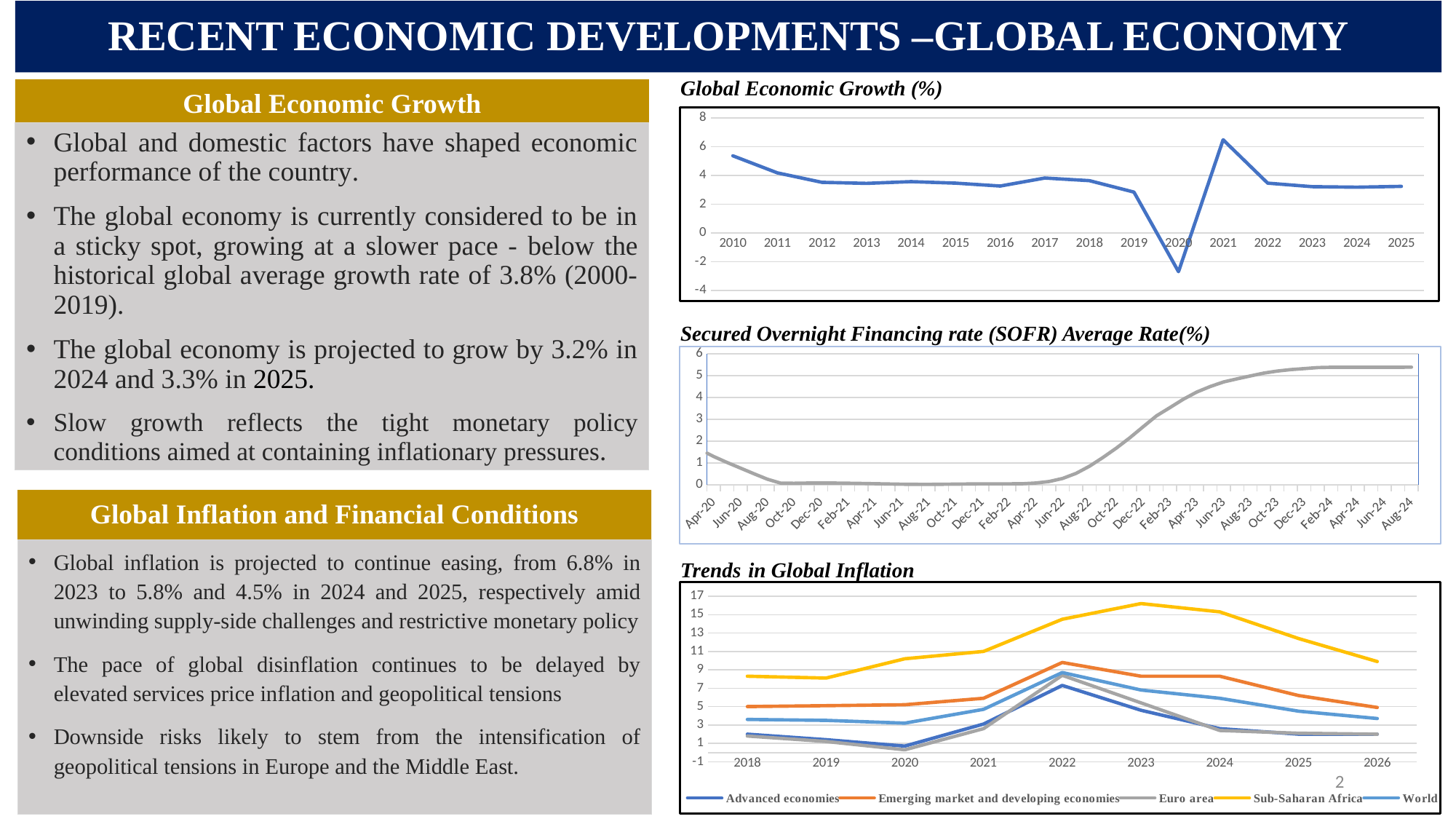
In the 'Trends in Global Inflation' chart, how many series does the legend list? 5 In the 'Global Economic Growth (%)' chart, is the value for 2021 greater or less than 6? greater In the 'Secured Overnight Financing rate (SOFR) Average Rate(%)' chart, is the value for Oct-20 greater or less than 1? less In the 'Global Economic Growth (%)' chart, how many years are shown on the x axis? 16 In the 'Global Economic Growth (%)' chart, which year has the highest value? 2021 In the 'Global Economic Growth (%)' chart, is the value for 2020 greater or less than 0? less In the 'Trends in Global Inflation' chart, which series has the highest value in 2023? Sub-Saharan Africa In the 'Trends in Global Inflation' chart, do the values for Sub-Saharan Africa rise or fall from 2023 to 2026? fall In the 'Global Economic Growth (%)' chart, which year has the lowest value? 2020 What kind of chart is the 'Global Economic Growth (%)' chart? line chart